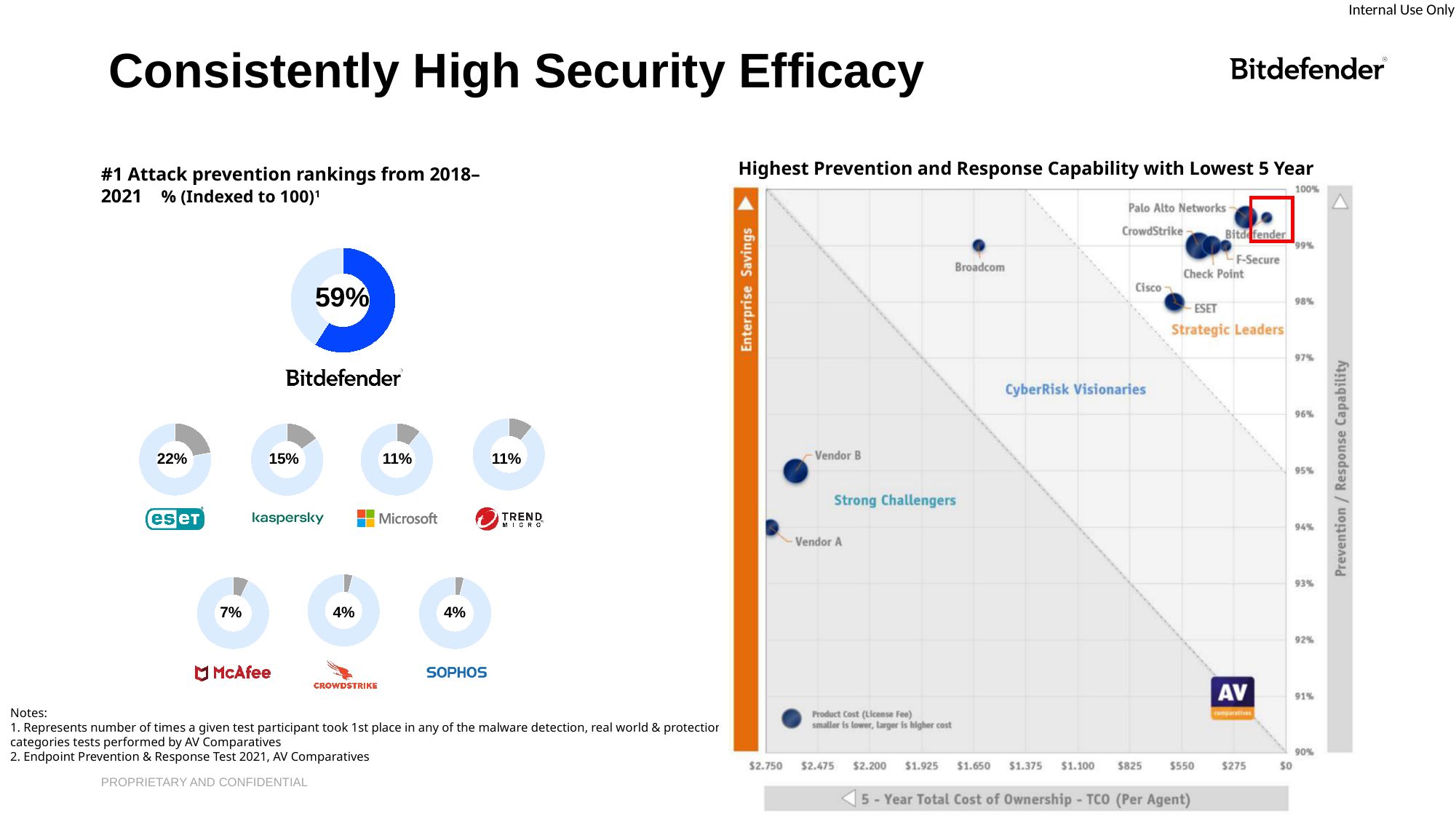
In the right-hand chart (Highest Prevention and Response Capability), is the Prevention / Response Capability for Broadcom greater or less than 98%? greater In the right-hand chart (Highest Prevention and Response Capability), is the Prevention / Response Capability for Vendor B greater or less than 96%? less In the left chart (#1 Attack prevention rankings from 2018–2021), what percentage is shown for Bitdefender? 59% In the right-hand chart (Highest Prevention and Response Capability), which labelled region is Bitdefender plotted in? Strategic Leaders In the left chart (#1 Attack prevention rankings from 2018–2021), which vendor has the highest percentage? Bitdefender In the left chart (#1 Attack prevention rankings from 2018–2021), which has the larger percentage, Microsoft or McAfee? Microsoft In the left chart (#1 Attack prevention rankings from 2018–2021), what percentage is shown for ESET? 22% In the left chart (#1 Attack prevention rankings from 2018–2021), what is the difference between Bitdefender's and ESET's percentages? 37 percentage points In the left chart (#1 Attack prevention rankings from 2018–2021), what percentage is shown for Sophos? 4% In the left chart (#1 Attack prevention rankings from 2018–2021), how many vendors are shown? 8 In the left chart (#1 Attack prevention rankings from 2018–2021), what percentage is shown for Kaspersky? 15% What kind of chart is used for each vendor in the left chart (#1 Attack prevention rankings from 2018–2021)? Donut (pie) chart